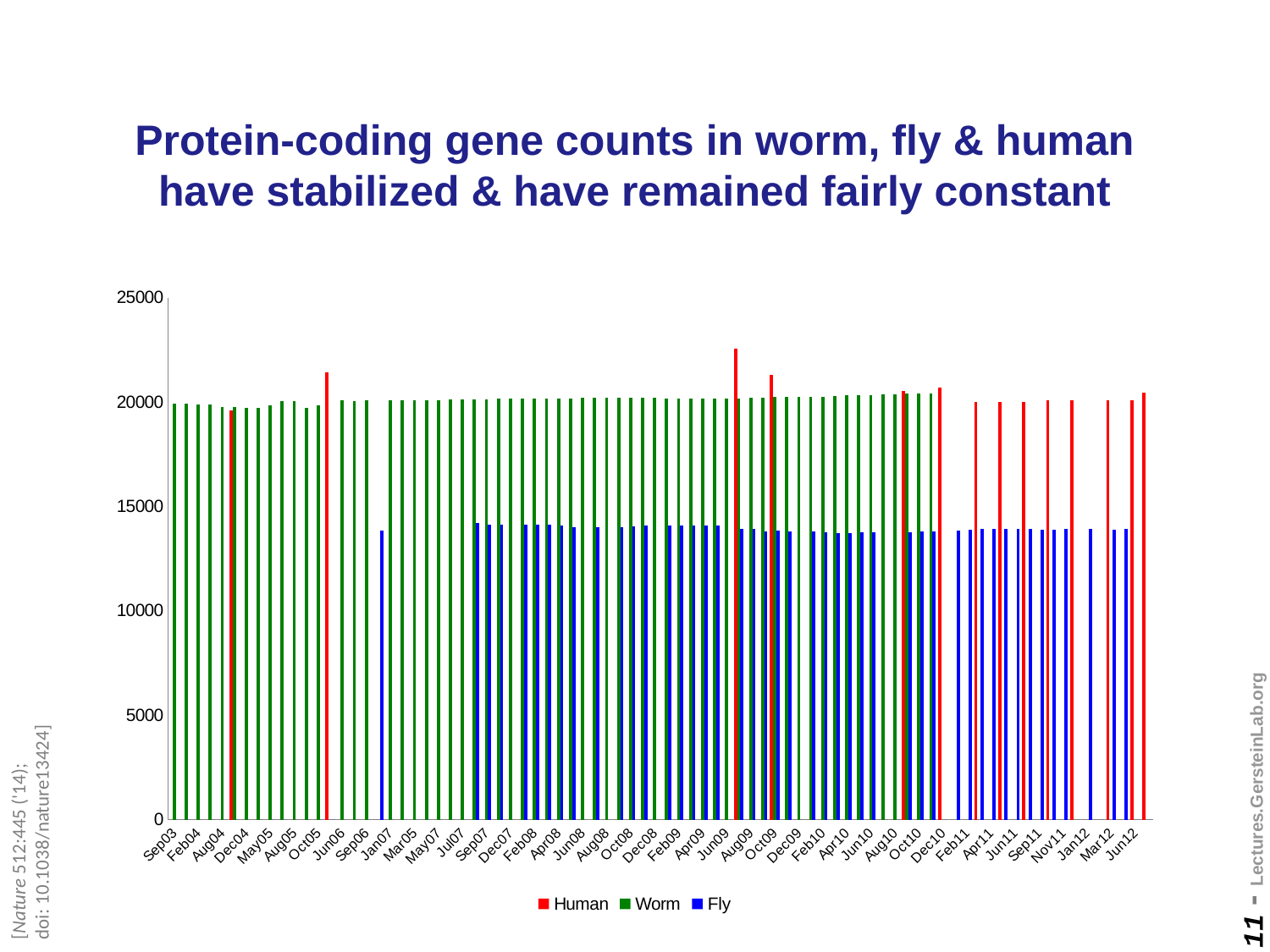
Which series is shown in blue in the legend? Fly How many series does the legend list? 3 Which series has the lowest values throughout the chart? Fly What kind of chart is shown on the slide? bar chart Which series has the single highest bar on the chart? Human At Dec08, which is larger, the Worm value or the Fly value? Worm At Oct09, which is larger, the Human value or the Fly value? Human What is the title of the slide's chart? Protein-coding gene counts in worm, fly & human have stabilized & have remained fairly constant Is the value for Worm at Sep03 greater or less than 15000? greater